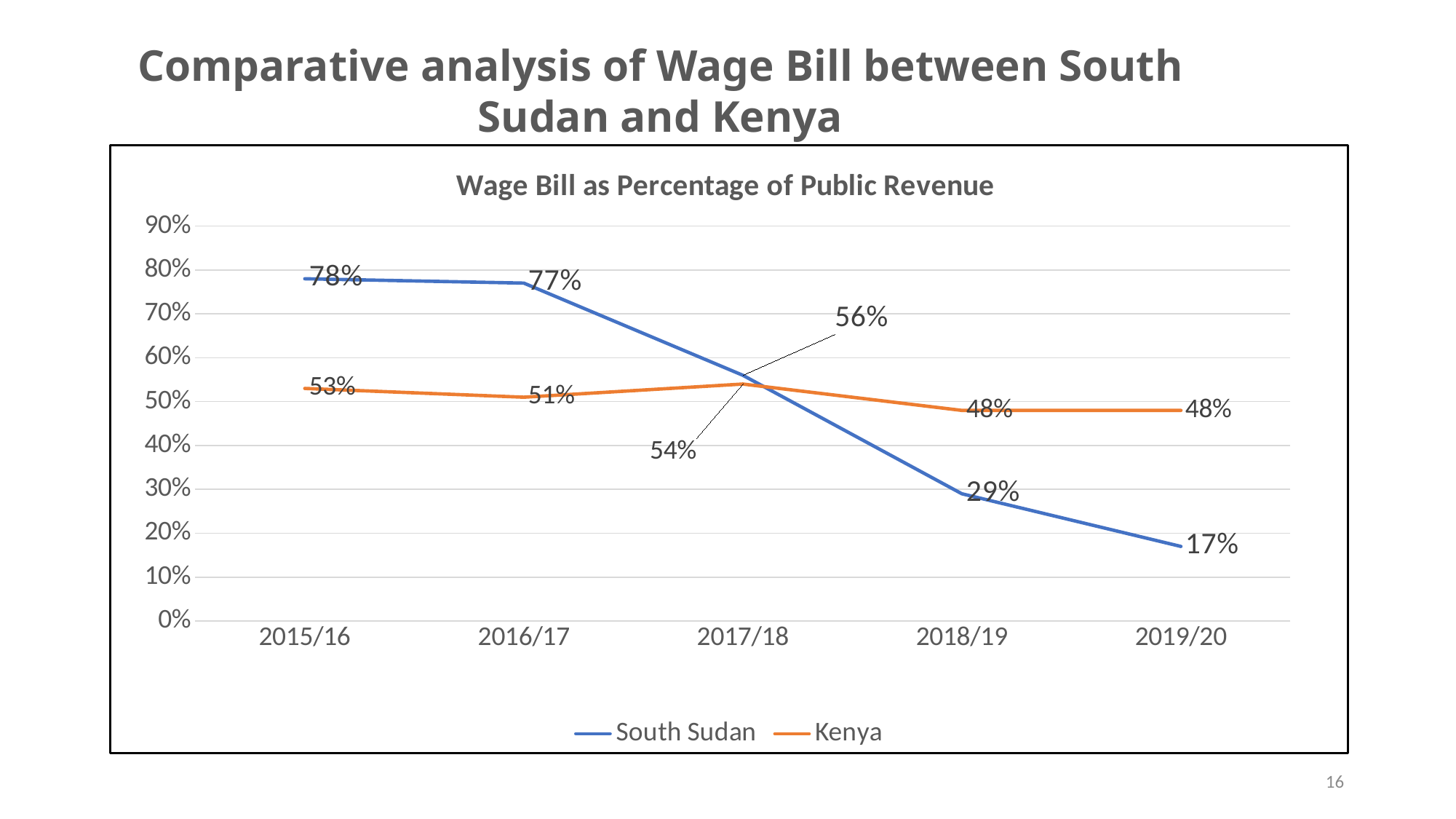
What type of chart is shown on the slide? Line chart What was Kenya's wage bill as a percentage of public revenue in 2019/20? 48% What value is shown for South Sudan in 2019/20? 17% How many series does the legend list? 2 Which country had the higher wage bill percentage in 2018/19? Kenya What was South Sudan's wage bill as a percentage of public revenue in 2015/16? 78% Which country had the higher wage bill percentage in 2015/16? South Sudan Does South Sudan's wage bill percentage rise or fall over the period shown? Fall How many fiscal years are plotted on the x axis? 5 What value is shown for Kenya in 2016/17? 51% What value is shown for South Sudan in 2018/19? 29% By how many percentage points did South Sudan's value fall from 2015/16 to 2019/20? 61 percentage points